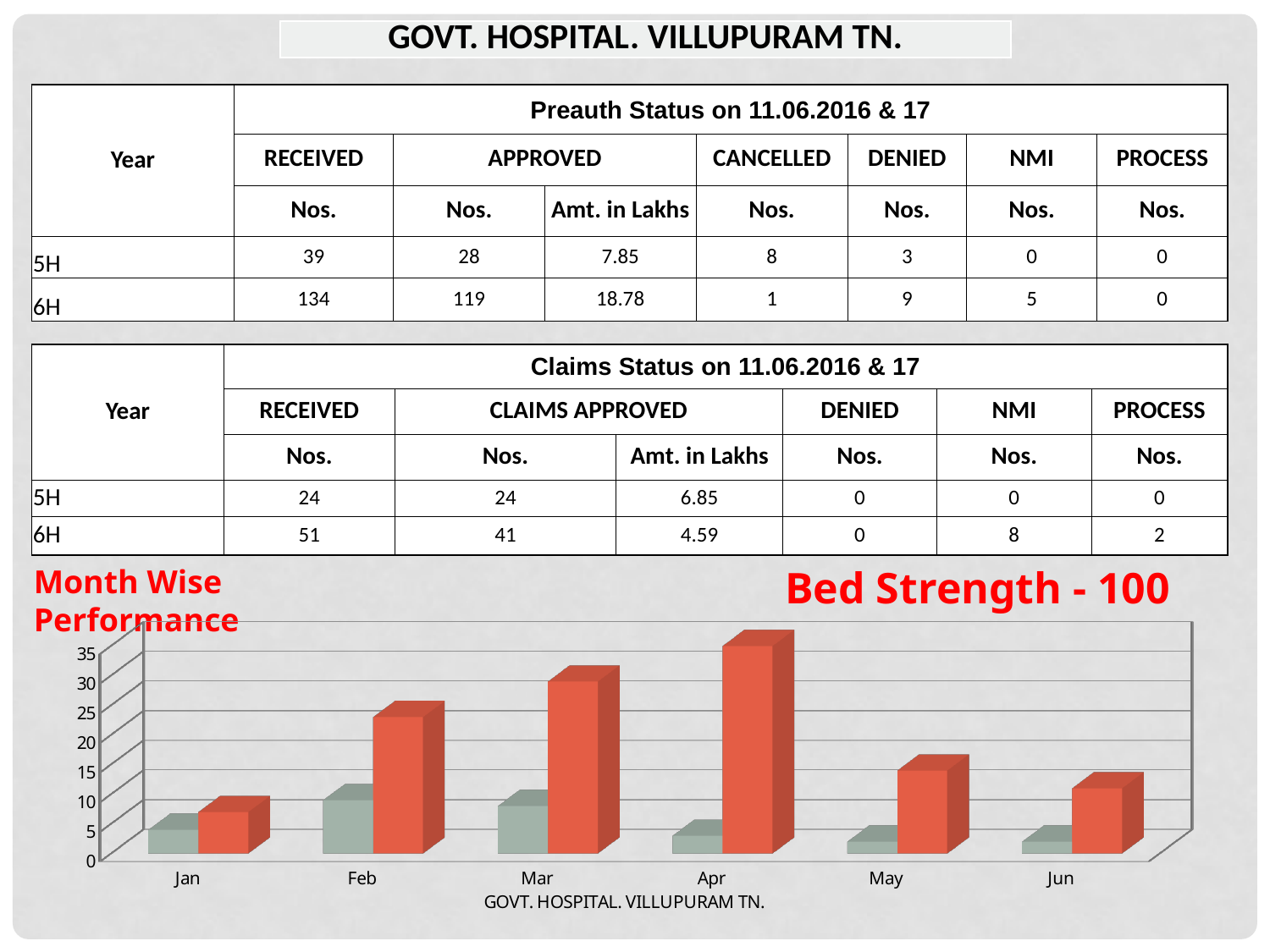
Which month has the larger red bar, Mar or May? Mar Do the red bars rise or fall from Jan to Apr? rise Is the value of the red bar for Feb greater or less than 15? greater Is the value of the red bar for Apr greater or less than 30? greater How many months are shown on the x axis of the chart? 6 What text appears as the axis title below the month labels of the chart? GOVT. HOSPITAL. VILLUPURAM TN. What kind of chart is shown at the bottom of the slide? bar chart In which month is the red bar the shortest? Jan In which month is the red bar the tallest? Apr Is the value of the red bar for Mar greater or less than 25? greater